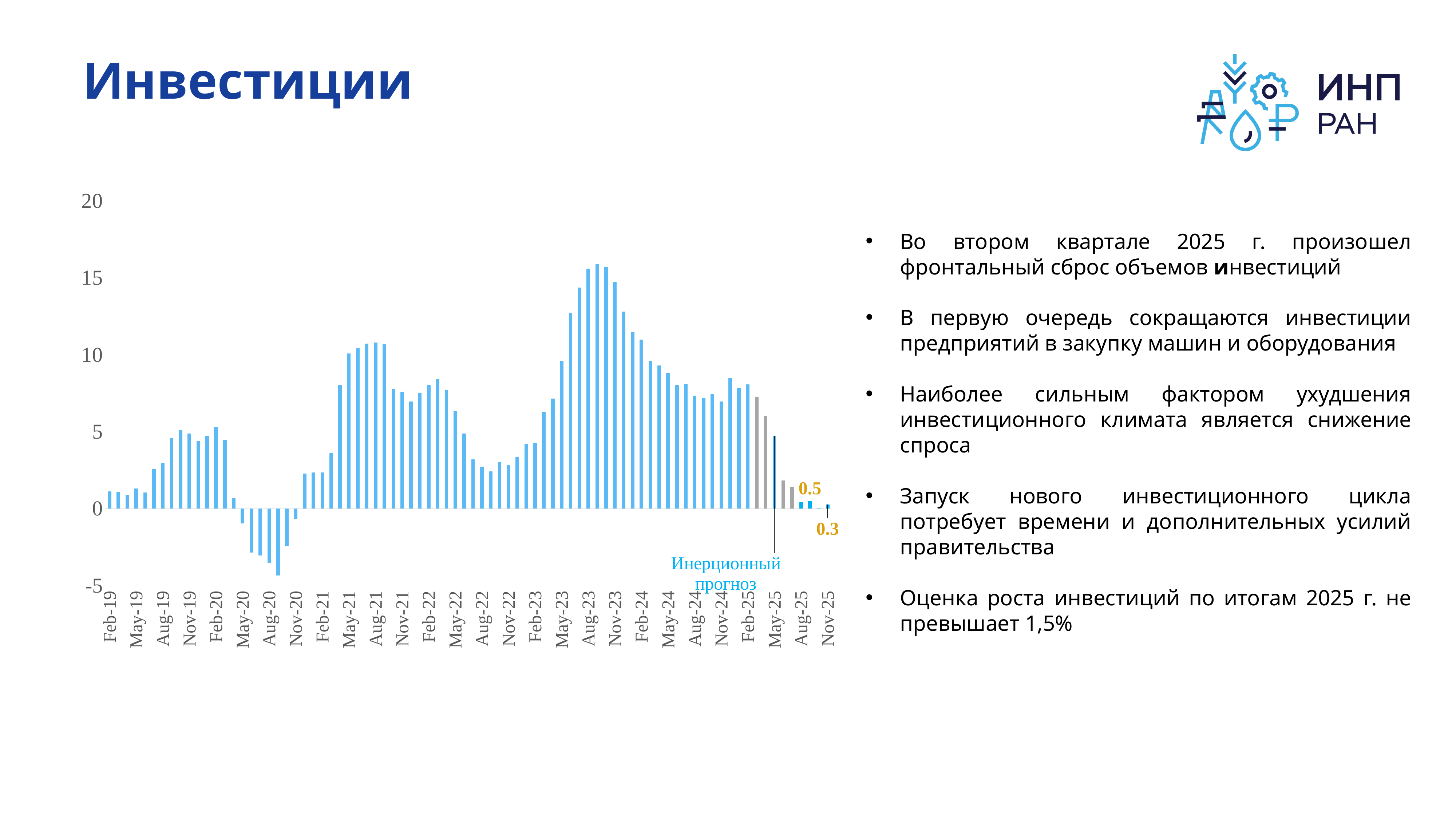
Is the value for Aug-23 greater or less than 15? greater What annotation text is written in blue below the chart near the 2025 bars? Инерционный прогноз What is the smaller of the two data labels printed on the chart? 0.3 Is the value for Aug-20 greater or less than 0? less Which is larger, the value for Aug-23 or the value for Aug-20? Aug-23 What kind of chart is shown on the slide? bar chart What is the title of the slide containing the chart? Инвестиции Do the values rise or fall from Nov-23 to Feb-24? fall Is the value for Feb-25 greater or less than 5? greater What is the larger of the two data labels printed on the chart? 0.5 How many period labels are shown on the x axis? 28